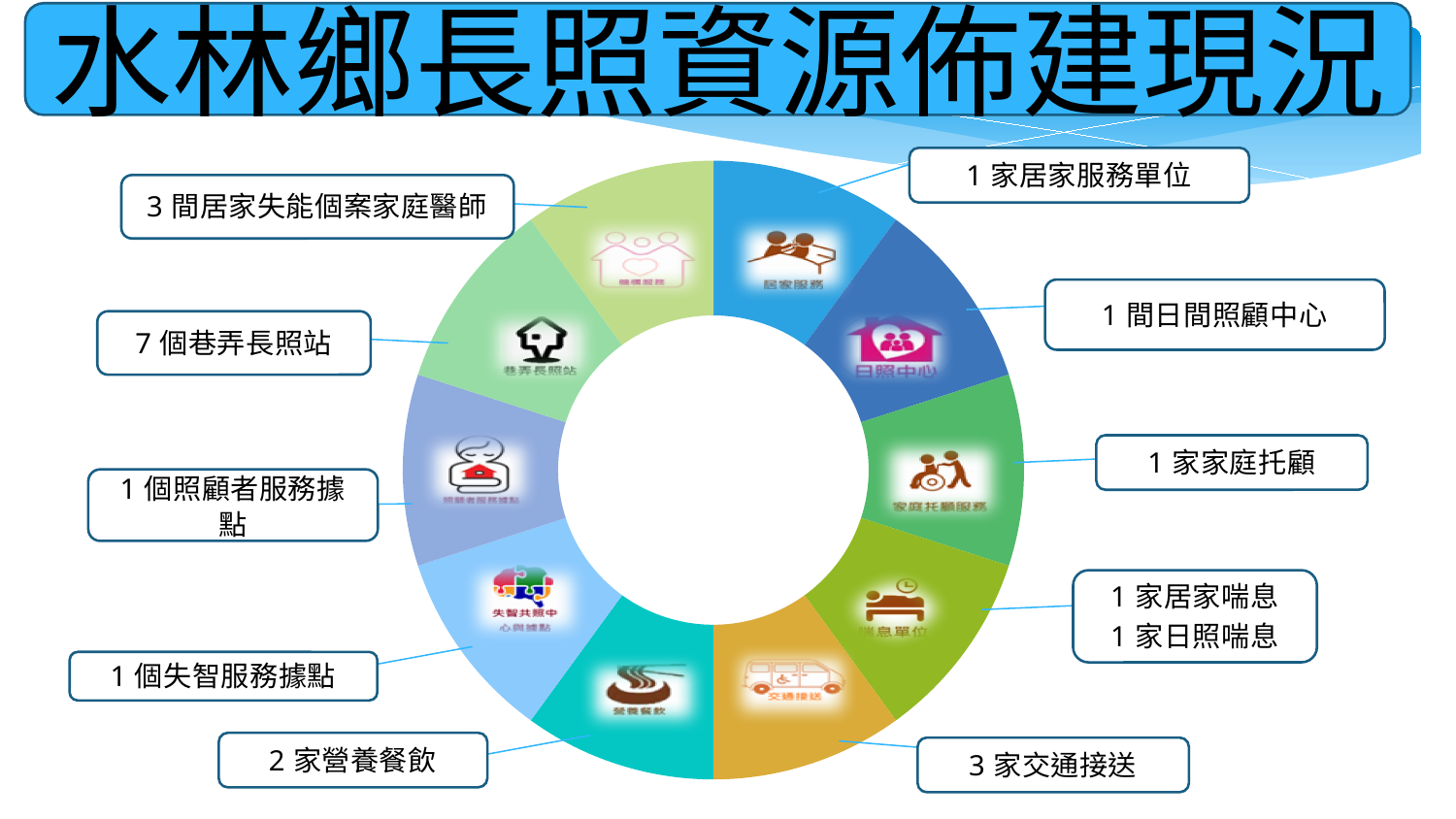
How many 居家失能個案家庭醫師 are listed in the callout? 3 間 What two items are listed in the 喘息 callout? 1 家居家喘息, 1 家日照喘息 How many segments does the ring diagram have? 10 How many 日間照顧中心 are listed in the callout? 1 間 Which resource has the largest number in its callout? 巷弄長照站 (7 個) What kind of chart is shown on the slide? donut (ring) chart What is the title of the slide's ring diagram? 水林鄉長照資源佈建現況 How many 營養餐飲 providers are listed in the callout? 2 家 How many 巷弄長照站 are listed in the callout? 7 個 How many 交通接送 providers are listed in the callout? 3 家 What is the difference between the number of 巷弄長照站 and the number of 交通接送 providers? 4 Which is larger, the number of 交通接送 providers or the number of 營養餐飲 providers? 交通接送